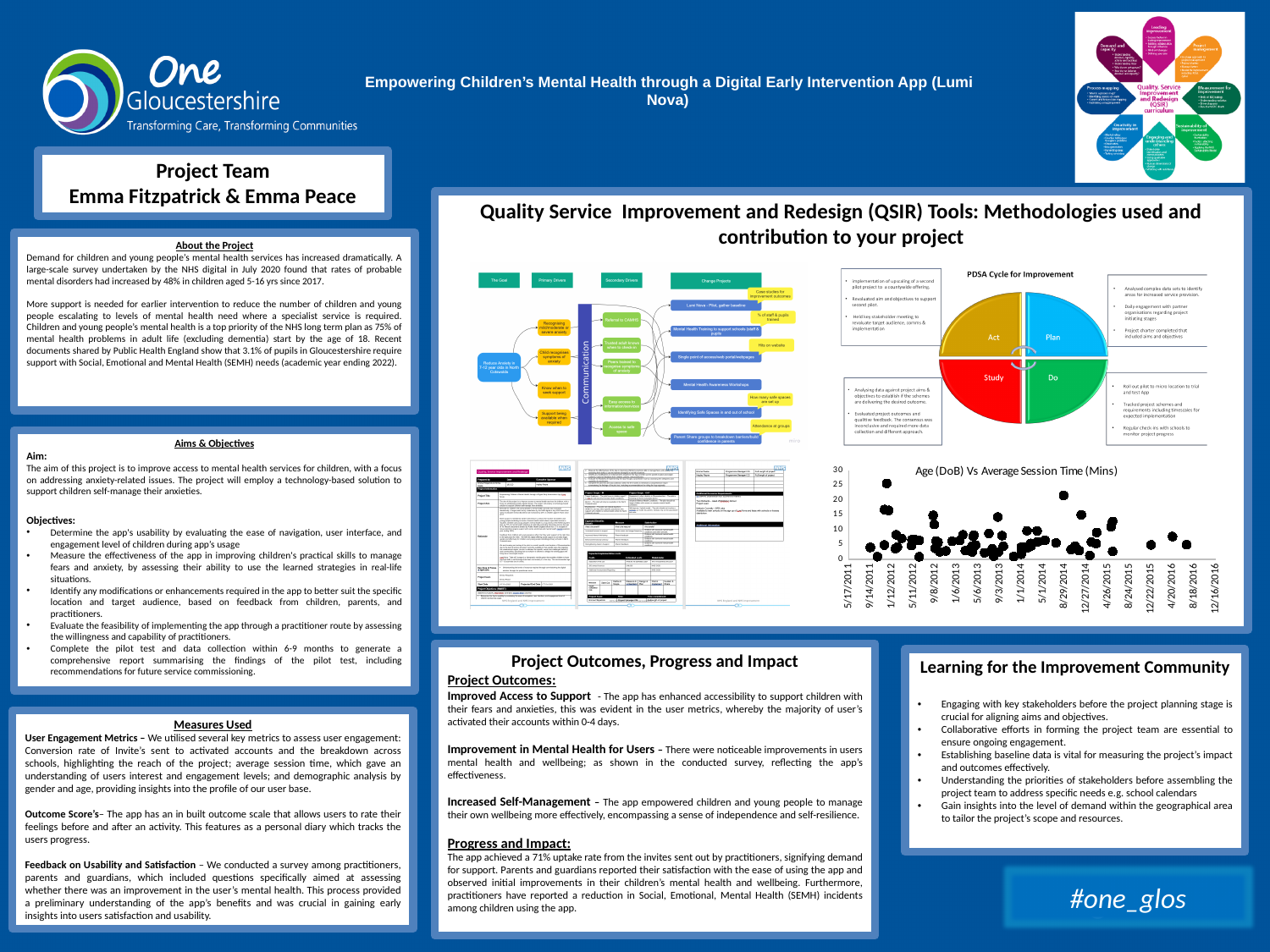
In the 'Age (DoB) Vs Average Session Time (Mins)' chart, what is the first date label on the horizontal axis? 5/17/2011 What is the title of the chart with the date axis on the right side of the slide? Age (DoB) Vs Average Session Time (Mins) In the 'Age (DoB) Vs Average Session Time (Mins)' chart, is the highest plotted point greater or less than 30? less In the 'Age (DoB) Vs Average Session Time (Mins)' chart, what is the last date label on the horizontal axis? 12/16/2016 What kind of chart is the 'Age (DoB) Vs Average Session Time (Mins)' chart? scatter chart In the 'Age (DoB) Vs Average Session Time (Mins)' chart, are most of the plotted points greater or less than 10? less In the 'Age (DoB) Vs Average Session Time (Mins)' chart, is the highest plotted point greater or less than 20? greater